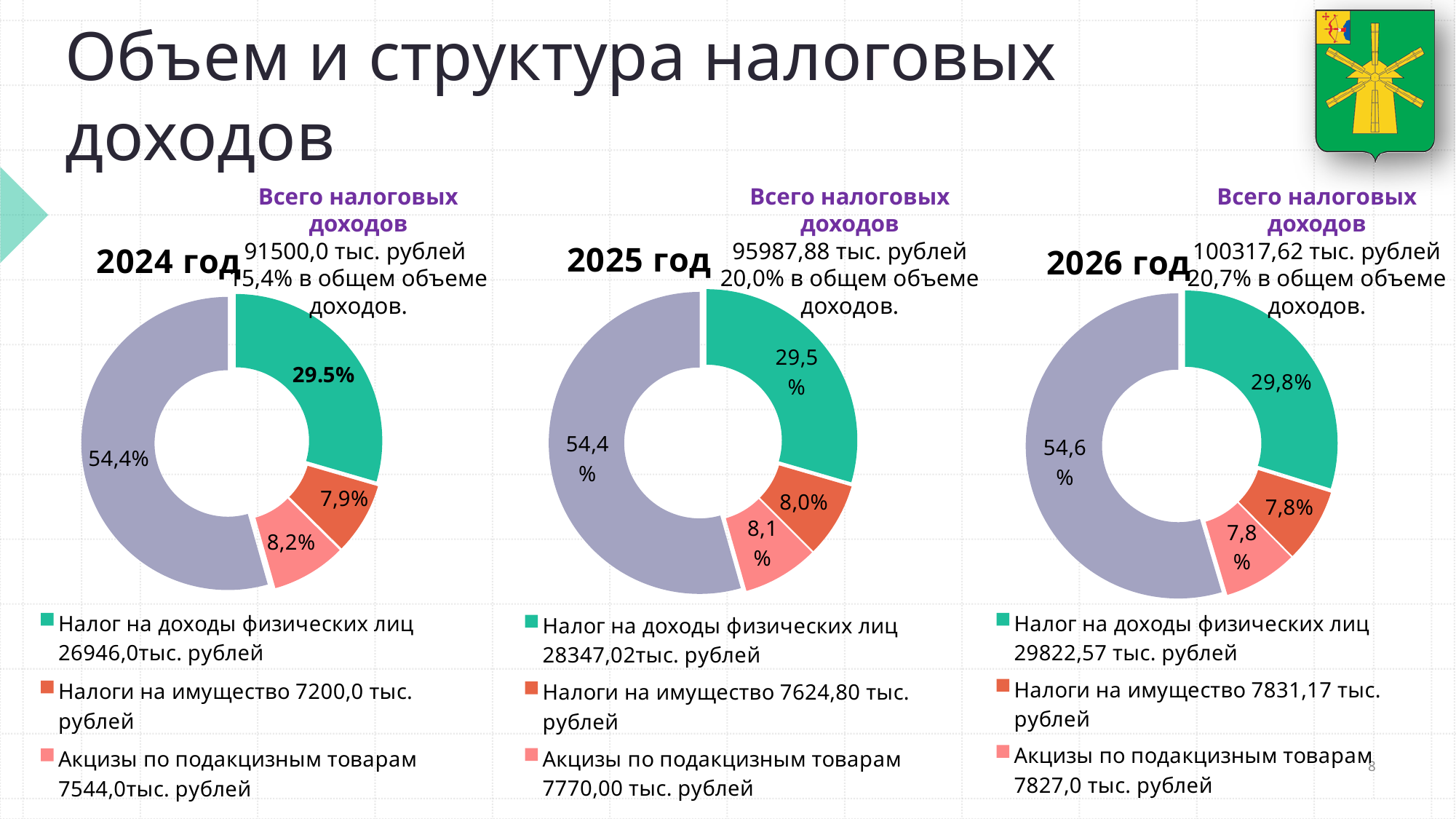
In the 2025 год chart, what share is shown for Налоги на имущество (orange slice)? 8,0% In the 2024 год chart, which is larger: the share for Налоги на имущество or the share for Акцизы по подакцизным товарам? Акцизы по подакцизным товарам In the 2026 год chart, what is the share of the largest (purple) slice? 54,6% According to the legend of the 2026 год chart, what amount is given for Налоги на имущество? 7831,17 тыс. рублей In the 2024 год chart, what is the difference between the share for Акцизы по подакцизным товарам (8,2%) and the share for Налоги на имущество (7,9%)? 0,3 percentage points How many entries does the legend of the 2026 год chart list? 3 In the 2026 год chart, what share is shown for Налог на доходы физических лиц (green slice)? 29,8% In the 2024 год chart, what share is shown for Налог на доходы физических лиц (green slice)? 29.5% Among the legend entries of the 2025 год chart, which category has the largest share? Налог на доходы физических лиц What type of chart is used for the 2024 год chart? Pie (donut) chart How many slices does the 2025 год chart have? 4 In the 2024 год chart, what share is shown for Акцизы по подакцизным товарам (pink slice)? 8,2%